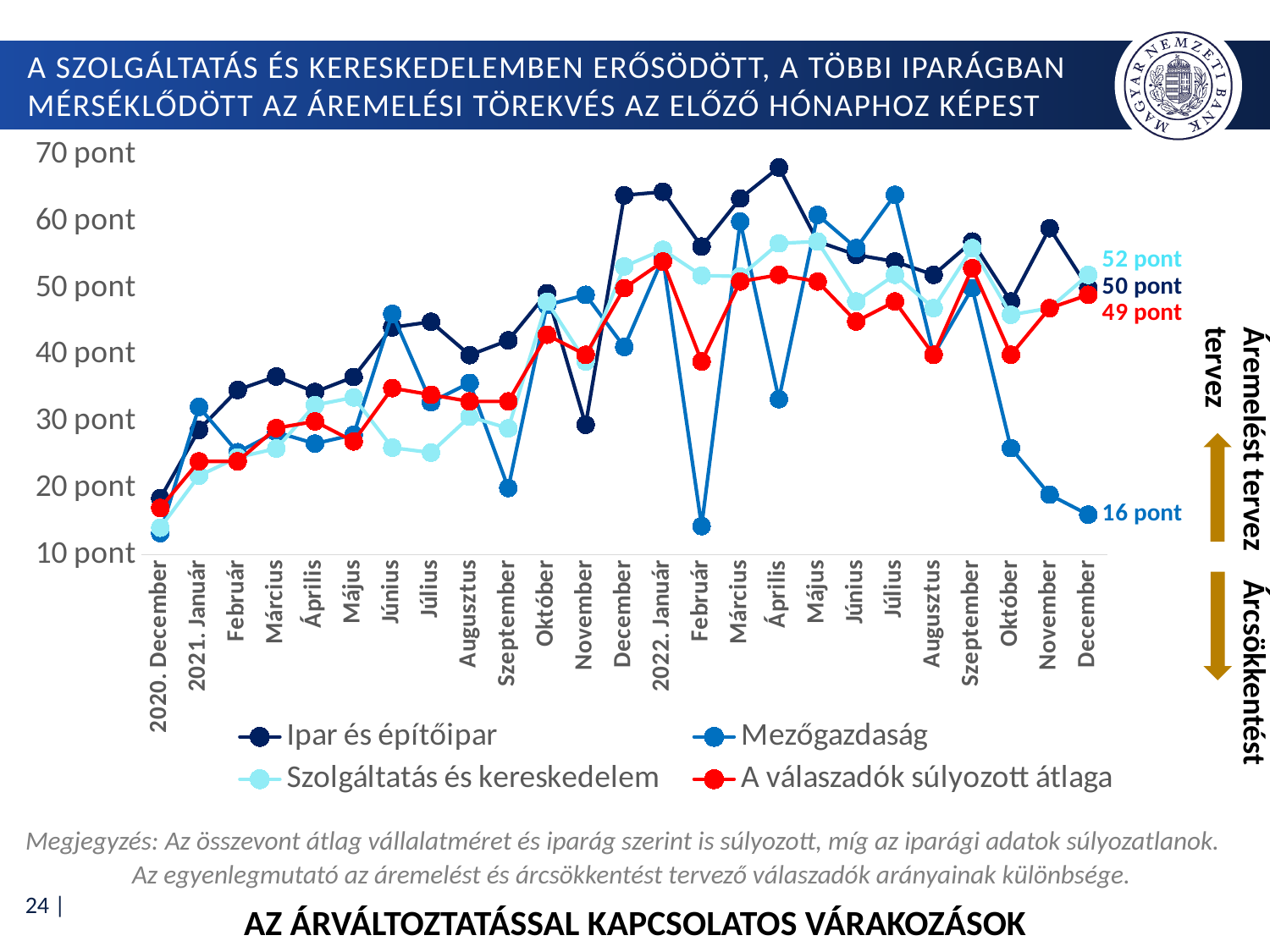
Which series has the highest value in 2022 December? Szolgáltatás és kereskedelem What is the value for Ipar és építőipar in 2022 December? 50 pont Which series has the lowest value in 2022 December? Mezőgazdaság Is the value for Ipar és építőipar in 2022 Április greater or less than 60 pont? greater Does the Mezőgazdaság series rise or fall from 2022 Szeptember to 2022 December? fall How many series does the legend list? 4 What is the value for Mezőgazdaság in 2022 December? 16 pont How many months are shown along the x axis? 25 What is the value for A válaszadók súlyozott átlaga in 2022 December? 49 pont What is the difference between the 2022 December values of Szolgáltatás és kereskedelem and Mezőgazdaság? 36 pont What is the value for Szolgáltatás és kereskedelem in 2022 December? 52 pont What kind of chart is shown on the slide? line chart